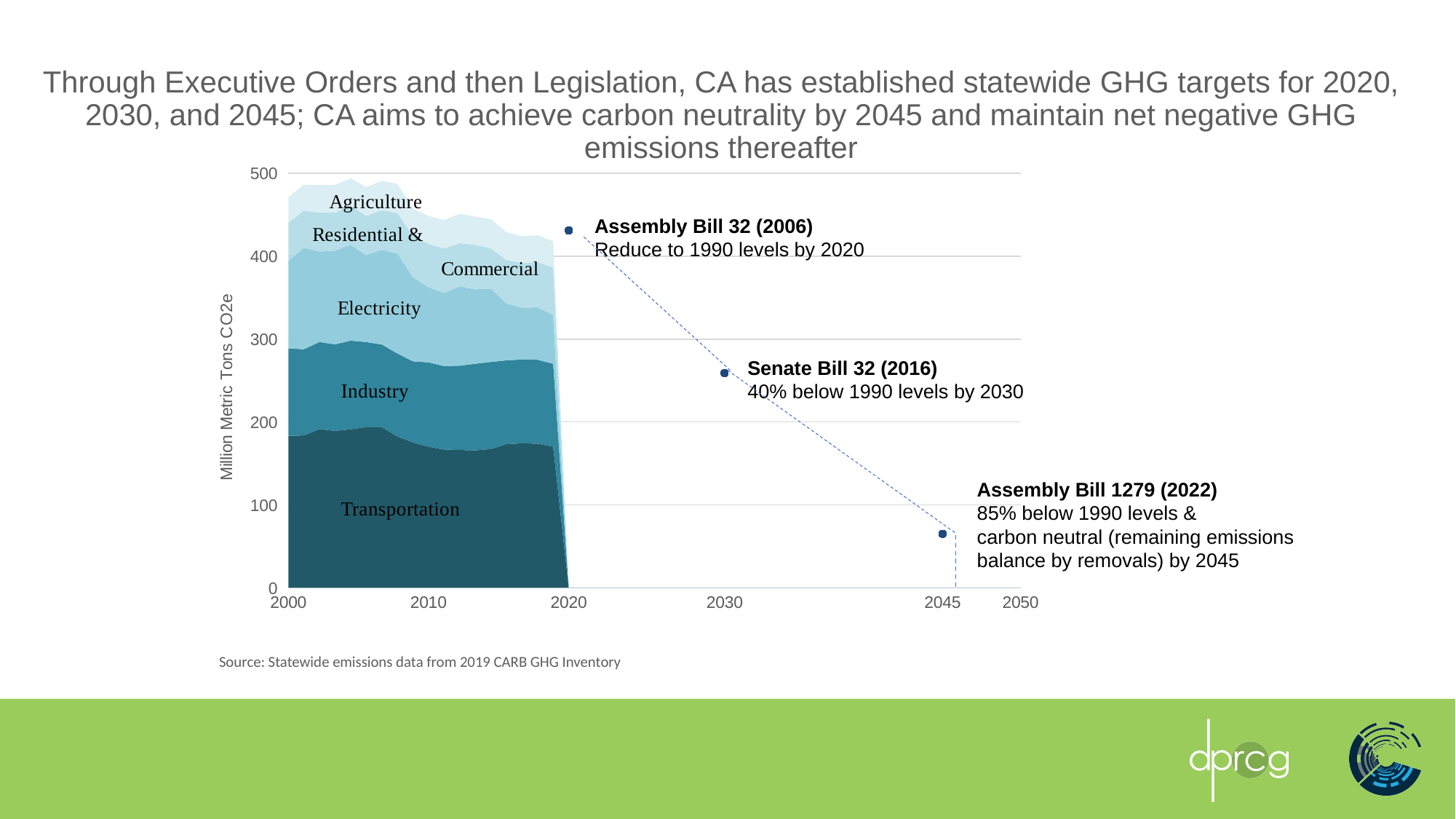
According to the chart annotation, what reduction does Senate Bill 32 (2016) target by 2030? 40% below 1990 levels Do total statewide emissions rise or fall between 2000 and 2020 in the chart? fall Which sector accounts for the smallest share of emissions in the stacked area chart? Agriculture How many emission sectors are labelled in the stacked area chart? 5 Is the 2030 target point (Senate Bill 32) greater or less than 200 million metric tons CO2e? greater Is the total emissions value in 2000 greater or less than 400 million metric tons CO2e? greater What is the label on the vertical axis of the chart? Million Metric Tons CO2e Which sector accounts for the largest share of emissions in the stacked area chart? Transportation What kind of chart is shown on the slide? Stacked area chart Is the value for Transportation emissions in 2000 greater or less than 100 million metric tons CO2e? greater Which is larger in the chart, the Industry band or the Electricity band? Industry